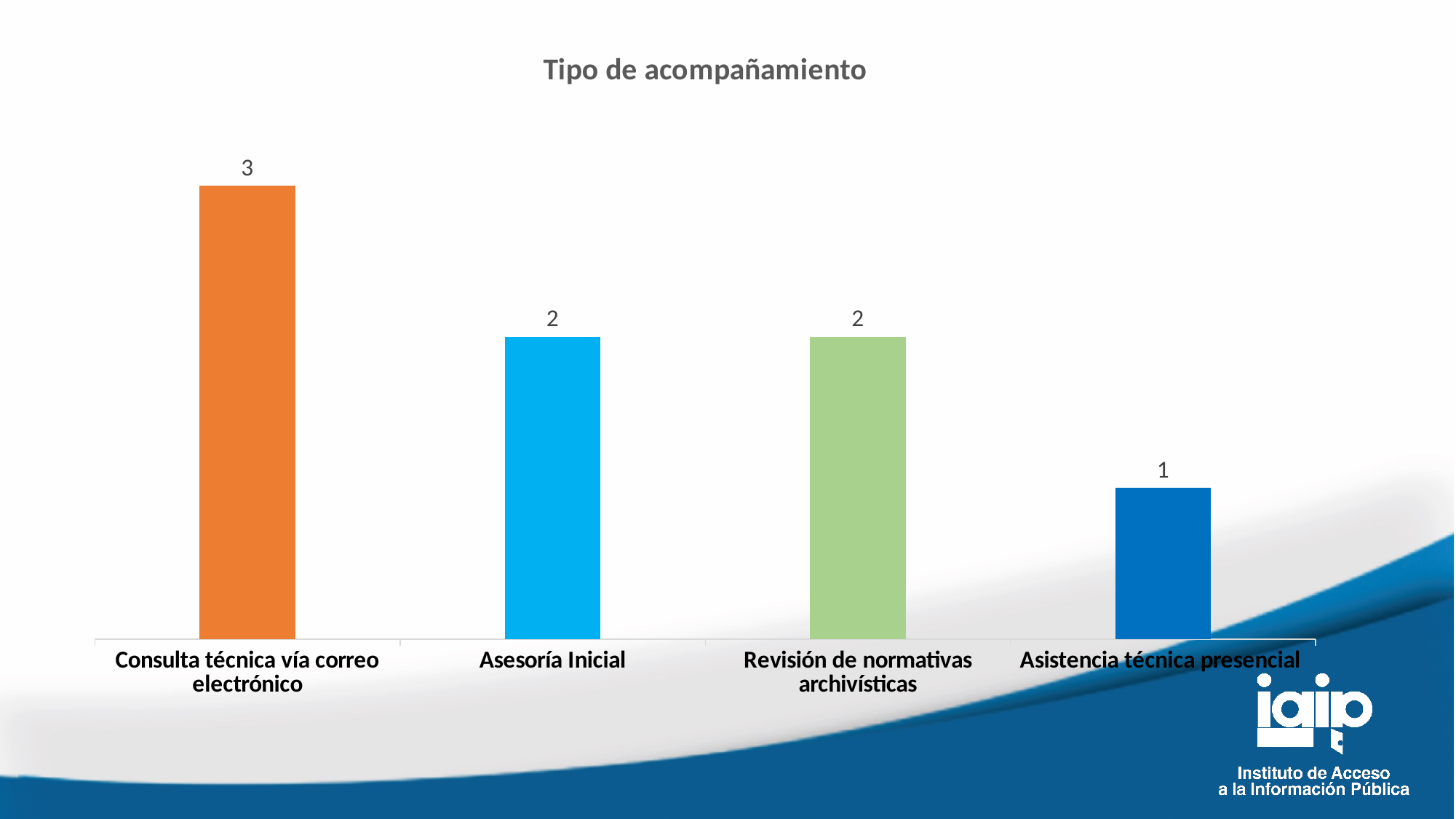
Which is larger, the value for Asesoría Inicial or the value for Asistencia técnica presencial? Asesoría Inicial What is the value for Revisión de normativas archivísticas? 2 Which category has the lowest value? Asistencia técnica presencial What is the value for Consulta técnica vía correo electrónico? 3 What is the value for Asesoría Inicial? 2 How many categories are shown in the chart? 4 What is the value for Asistencia técnica presencial? 1 Do the values rise or fall from left to right across the categories? Fall What is the title of the chart? Tipo de acompañamiento What is the difference between the values for Consulta técnica vía correo electrónico and Asistencia técnica presencial? 2 Which category has the highest value? Consulta técnica vía correo electrónico What kind of chart is shown on the slide? Bar chart